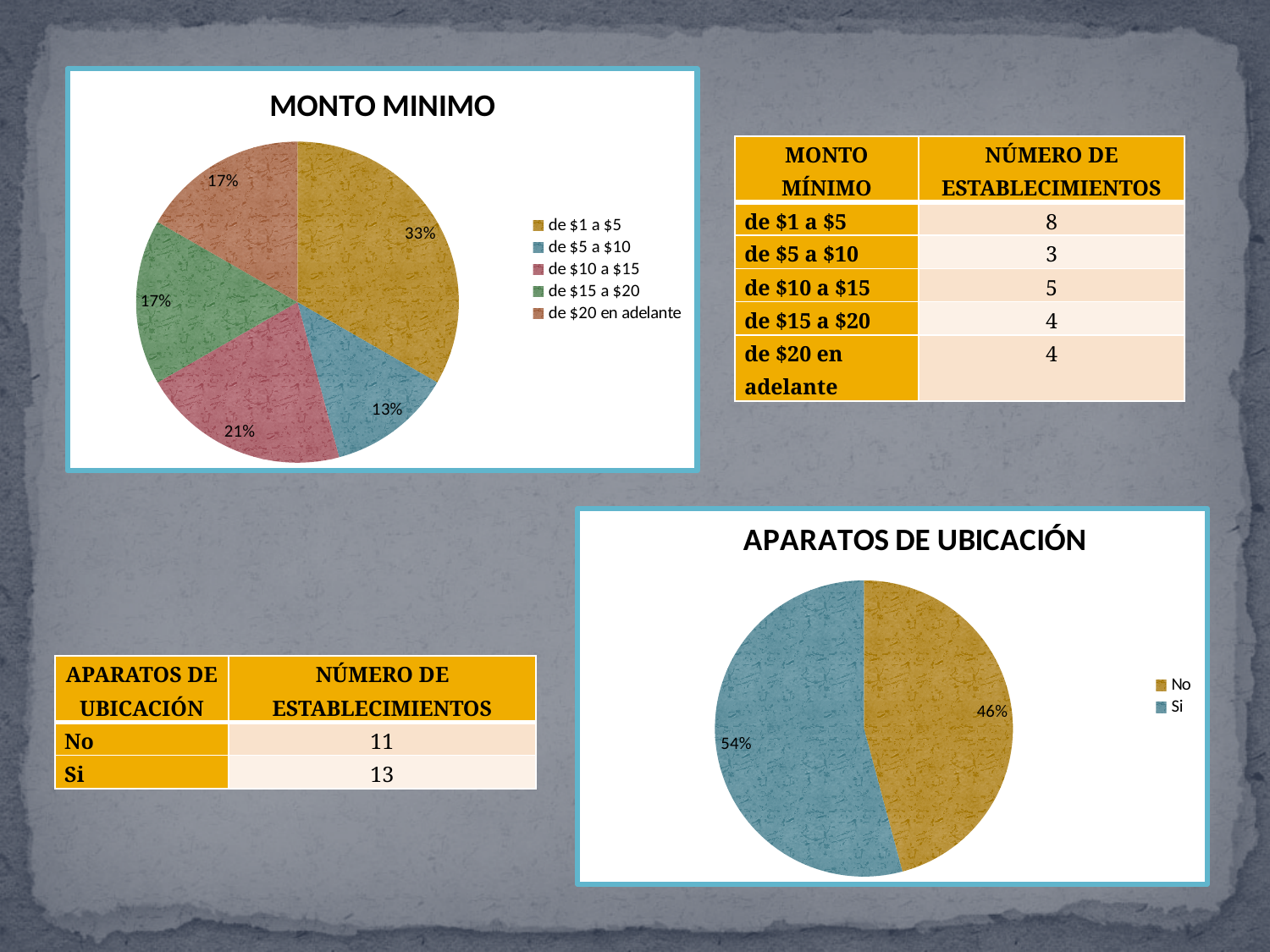
In the APARATOS DE UBICACIÓN chart, which slice is larger, No or Si? Si In the MONTO MINIMO chart, what share of the pie is the slice for de $5 a $10? 13% In the MONTO MINIMO chart, what is the difference in percentage points between the de $1 a $5 slice and the de $10 a $15 slice? 12 In the APARATOS DE UBICACIÓN chart, what share of the pie is the No slice? 46% In the MONTO MINIMO chart, which category has the largest slice? de $1 a $5 In the MONTO MINIMO chart, which category has the smallest slice? de $5 a $10 What kind of chart is the MONTO MINIMO chart? Pie chart In the APARATOS DE UBICACIÓN chart, how many categories does the legend list? 2 In the MONTO MINIMO chart, how many categories does the legend list? 5 In the APARATOS DE UBICACIÓN chart, what share of the pie is the Si slice? 54%